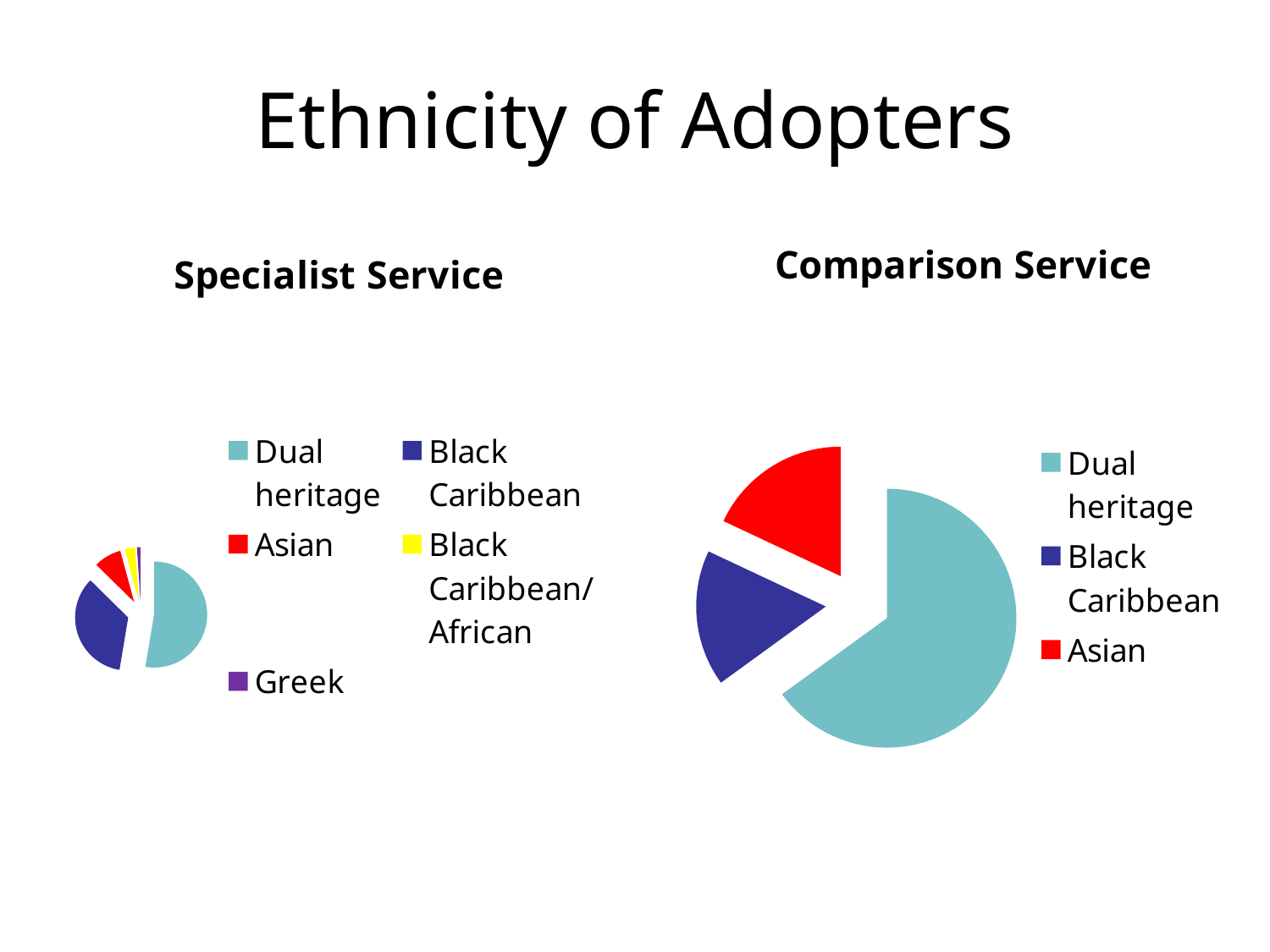
In the Comparison Service chart, which slice is larger: Dual heritage or Asian? Dual heritage In the Specialist Service chart, which ethnicity has the largest slice? Dual heritage In the Comparison Service chart, how many ethnicity categories are shown? 3 In the Specialist Service chart, which slice is larger: Dual heritage or Black Caribbean? Dual heritage In the Specialist Service chart, which slice is larger: Black Caribbean or Asian? Black Caribbean What kind of chart is the Specialist Service chart? pie chart In the Specialist Service chart, how many ethnicity categories are shown? 5 In the Specialist Service chart, what colour represents Asian? red What kind of chart is the Comparison Service chart? pie chart In the Specialist Service chart, which ethnicity has the smallest slice? Greek In the Comparison Service chart, which ethnicity has the largest slice? Dual heritage Which ethnicity category appears in the Specialist Service legend but not in the Comparison Service legend, besides Greek? Black Caribbean/African